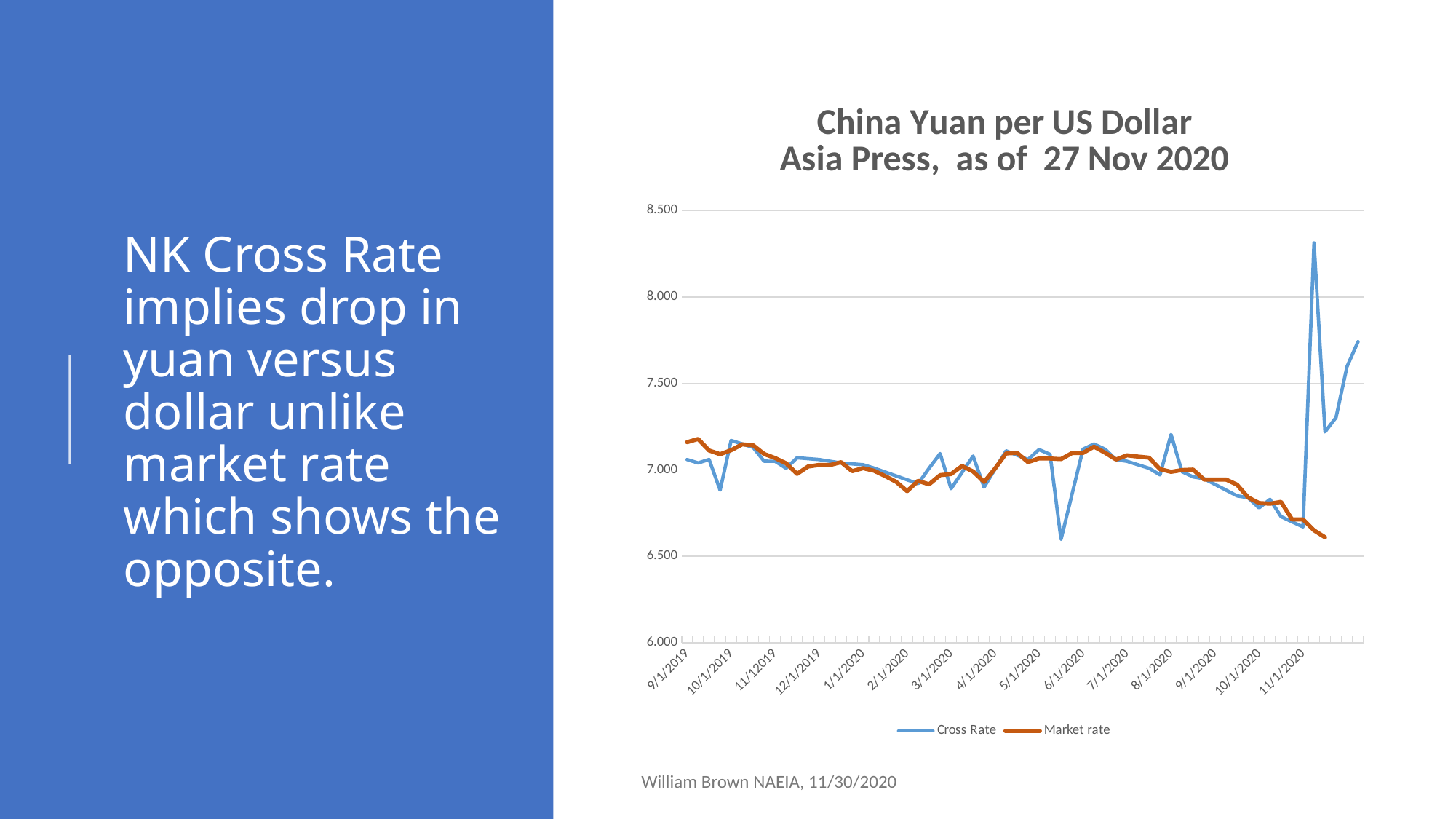
Is the Market rate value at 9/1/2019 greater or less than 7.000? greater Is the highest value reached by the Cross Rate series greater or less than 8.000? greater How many series does the chart legend list? 2 Which series reaches the highest value on the chart? Cross Rate Does the Market rate series generally rise or fall from 9/1/2019 to 11/1/2020? fall Is the lowest Cross Rate value around 6/1/2020 greater or less than 7.000? less What kind of chart is shown on the slide? line chart Which series is higher in late November 2020, Cross Rate or Market rate? Cross Rate What are the two series named in the chart legend? Cross Rate and Market rate What is the title of the chart? China Yuan per US Dollar Asia Press, as of 27 Nov 2020 How many date labels are shown on the x axis? 15